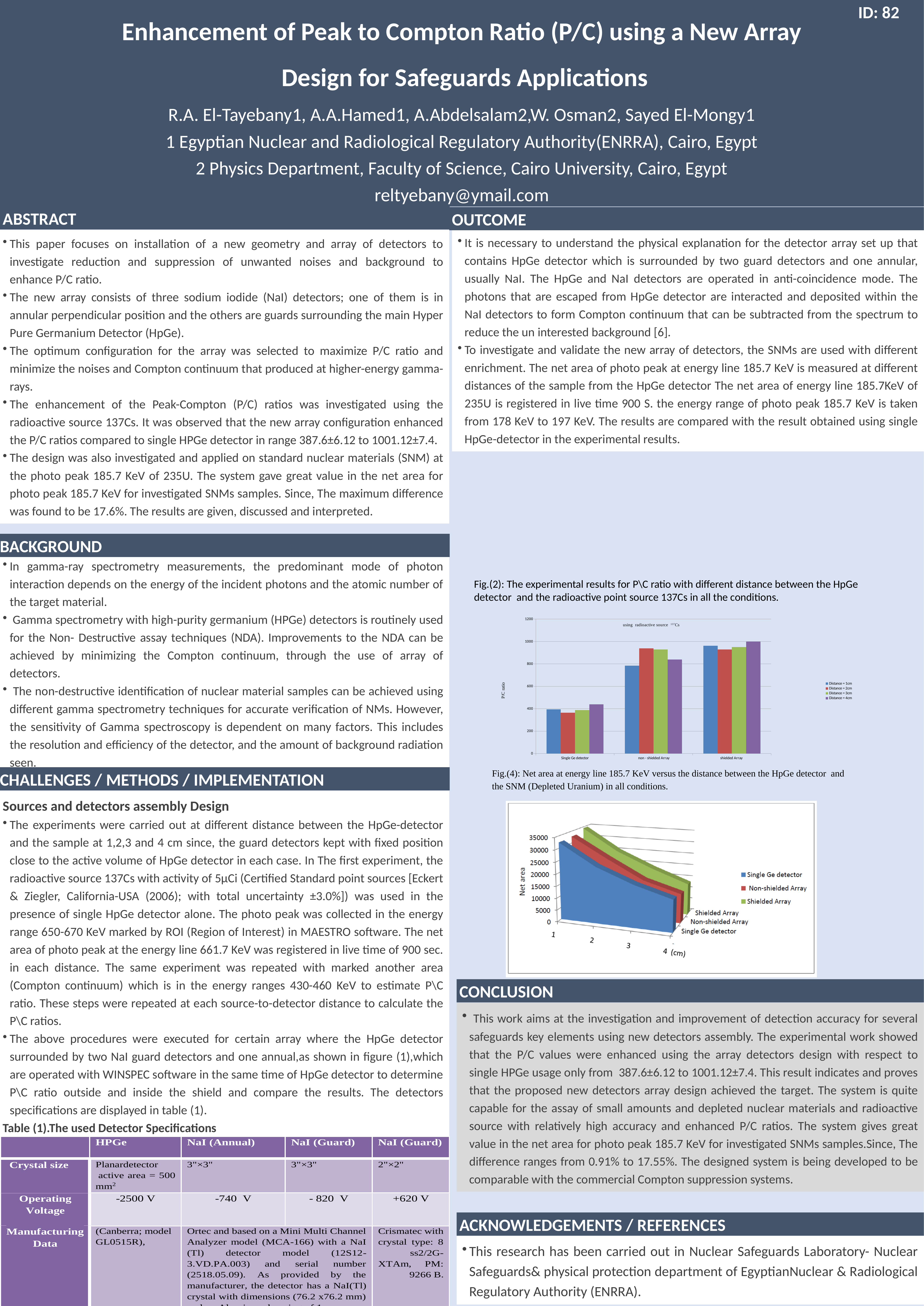
In Fig.(4), how many series does the legend list? 3 In Fig.(2), what is the label on the vertical axis? P/C ratio In Fig.(2), how many detector configurations are shown along the x axis? 3 In Fig.(2), what kind of chart is used to show the P/C ratio results? bar chart In Fig.(2), is the P/C ratio for the non-shielded Array at Distance = 2cm greater or less than 800? greater In Fig.(2), is the P/C ratio for the Single Ge detector at Distance = 4cm greater or less than 600? less In Fig.(2), at Distance = 1cm, which has the larger P/C ratio: the Single Ge detector or the shielded Array? shielded Array In Fig.(2), which configuration has the lowest P/C ratio at Distance = 4cm? Single Ge detector In Fig.(2), is the P/C ratio for the shielded Array at Distance = 4cm greater or less than 800? greater In Fig.(2), how many series does the legend list? 4 In Fig.(2), which configuration has the highest P/C ratio at Distance = 4cm? shielded Array In Fig.(4), does the net area rise or fall as the distance increases from 1 to 4 cm? fall